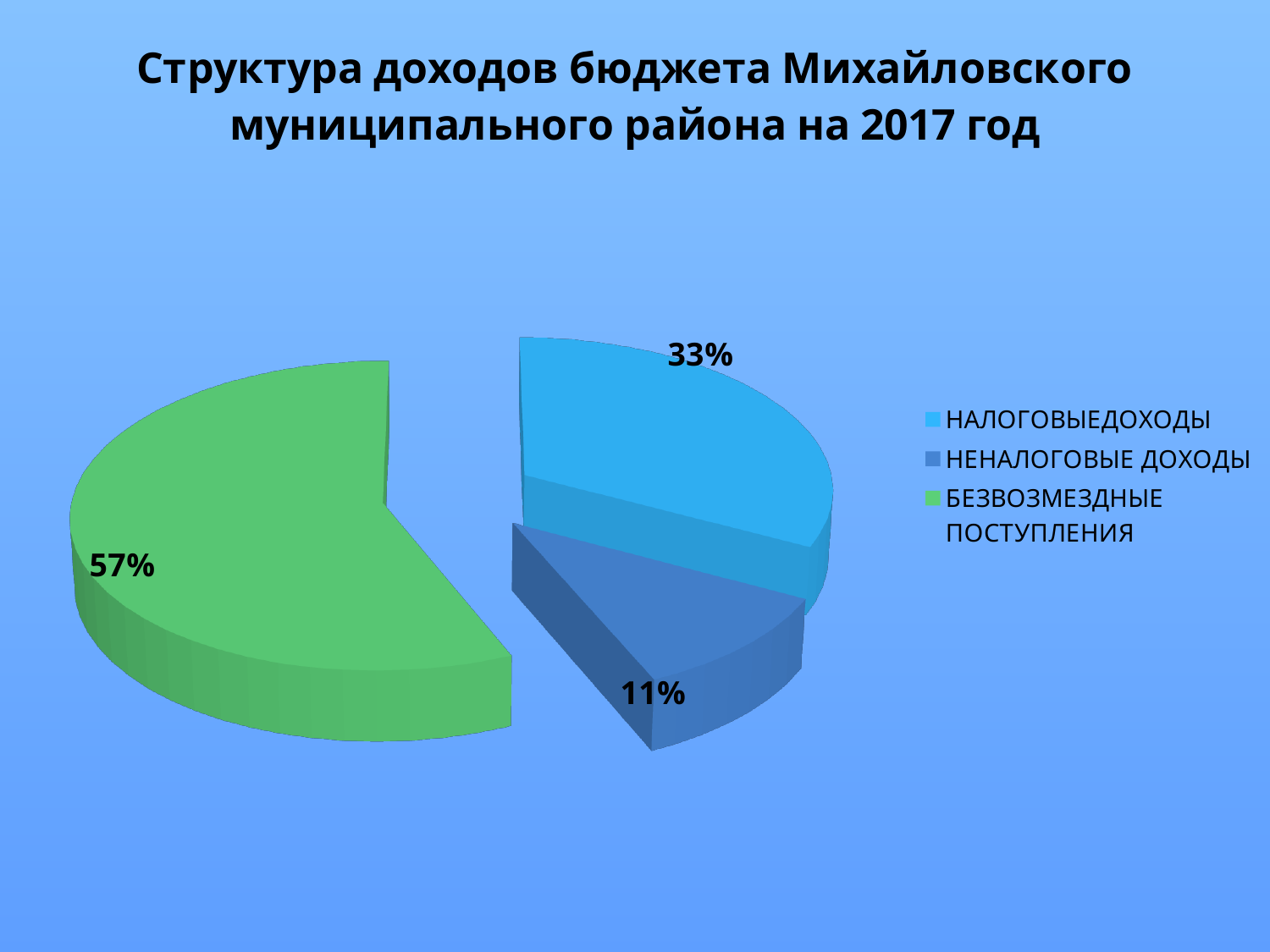
What kind of chart is shown on the slide? Pie chart What share of the pie does НАЛОГОВЫЕ ДОХОДЫ represent? 33% What is the difference in percentage points between БЕЗВОЗМЕЗДНЫЕ ПОСТУПЛЕНИЯ and НАЛОГОВЫЕ ДОХОДЫ? 24 percentage points Which category has the largest slice of the pie? БЕЗВОЗМЕЗДНЫЕ ПОСТУПЛЕНИЯ What share of the pie does БЕЗВОЗМЕЗДНЫЕ ПОСТУПЛЕНИЯ represent? 57% What colour is the slice for БЕЗВОЗМЕЗДНЫЕ ПОСТУПЛЕНИЯ? Green Which is larger, the share for НАЛОГОВЫЕ ДОХОДЫ or the share for НЕНАЛОГОВЫЕ ДОХОДЫ? НАЛОГОВЫЕ ДОХОДЫ How many slices does the pie chart have? 3 Which category has the smallest slice of the pie? НЕНАЛОГОВЫЕ ДОХОДЫ What is the difference in percentage points between НАЛОГОВЫЕ ДОХОДЫ and НЕНАЛОГОВЫЕ ДОХОДЫ? 22 percentage points What share of the pie does НЕНАЛОГОВЫЕ ДОХОДЫ represent? 11% What is the title of the slide? Структура доходов бюджета Михайловского муниципального района на 2017 год